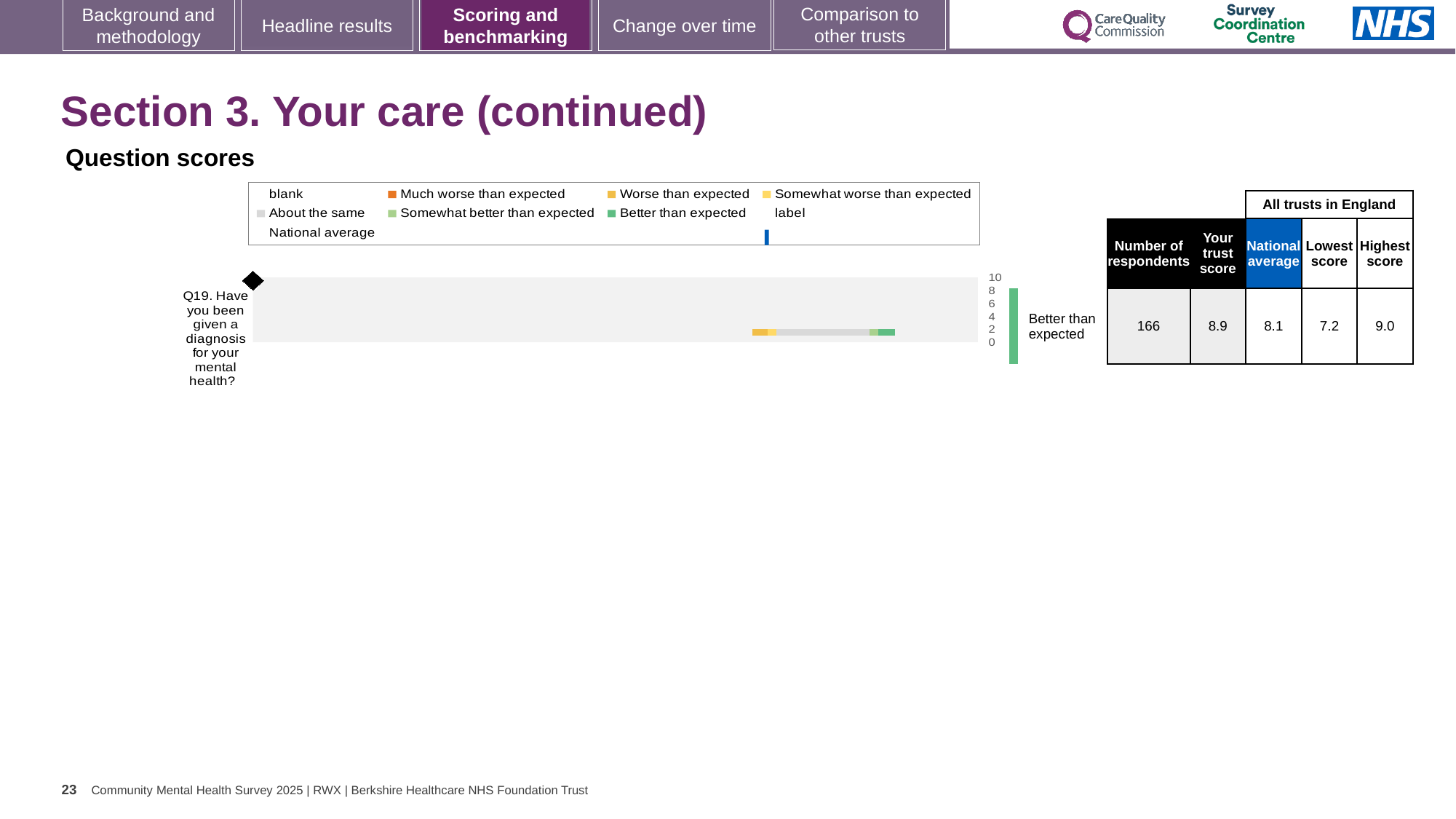
What kind of chart is used to show the question scores? Bar chart What is the trust score for Q19 (Have you been given a diagnosis for your mental health?)? 8.9 How many questions are plotted on the chart? 1 What is the difference between the highest and lowest scores across all trusts in England for Q19? 1.8 Which is larger for Q19, the trust score or the national average? Trust score How many respondents answered Q19? 166 What benchmark category is the trust's Q19 score placed in? Better than expected What is the national average score for Q19? 8.1 Is the trust score for Q19 greater or less than 8 on the chart's axis? greater By how much does the trust score for Q19 exceed the national average? 0.8 What is the lowest score among all trusts in England for Q19? 7.2 What is the highest score among all trusts in England for Q19? 9.0